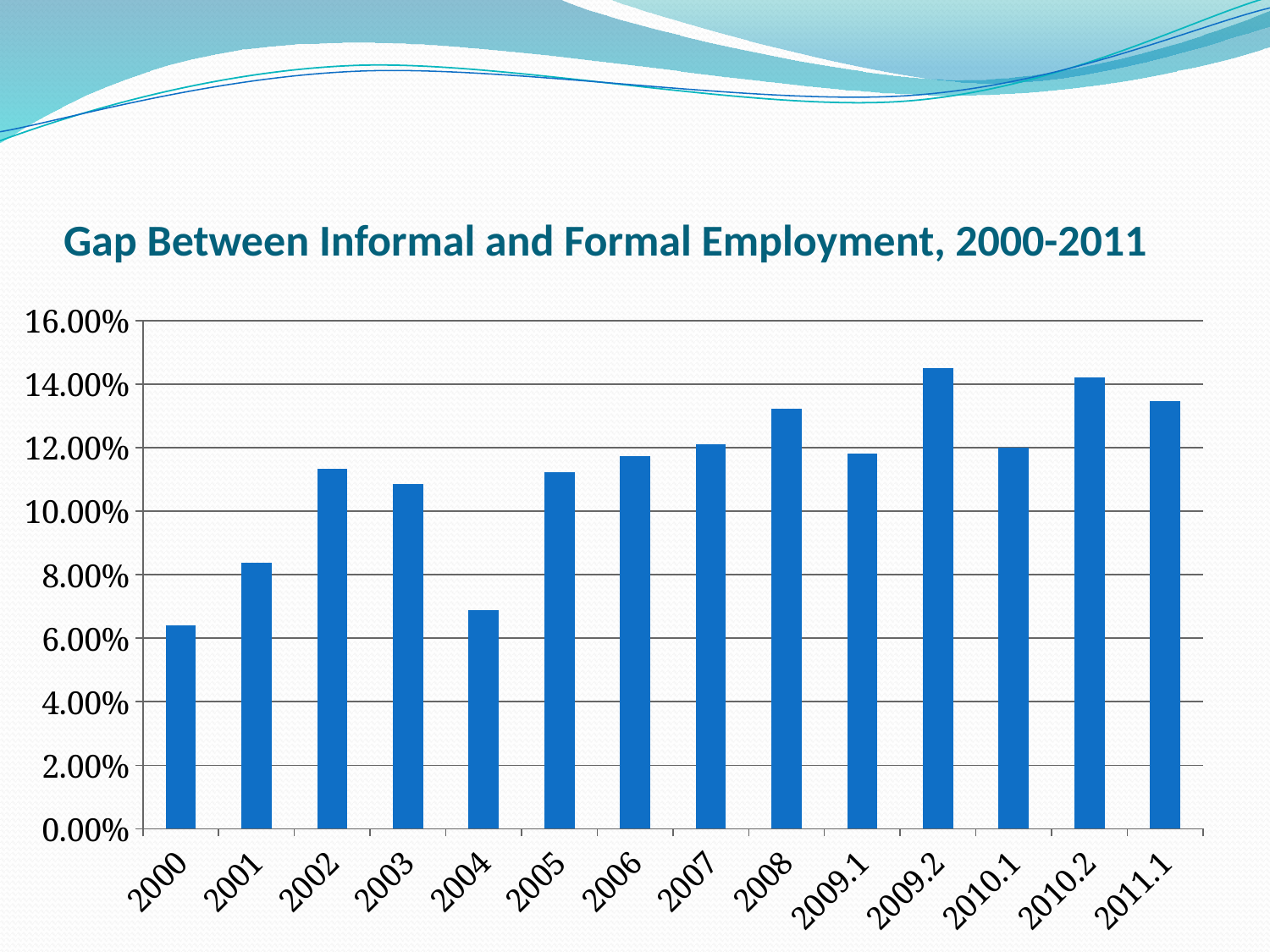
What kind of chart is shown on the slide? bar chart Is the value for 2000 greater or less than 8.00%? less Is the value for 2009.2 greater or less than 14.00%? greater What is the title of the chart? Gap Between Informal and Formal Employment, 2000-2011 Which is larger, the value for 2001 or the value for 2004? 2001 Which period has the lowest value in the chart? 2000 Is the value for 2008 greater or less than 12.00%? greater Which is larger, the value for 2002 or the value for 2003? 2002 Which period has the highest value in the chart? 2009.2 How many bars (periods) are plotted in the chart? 14